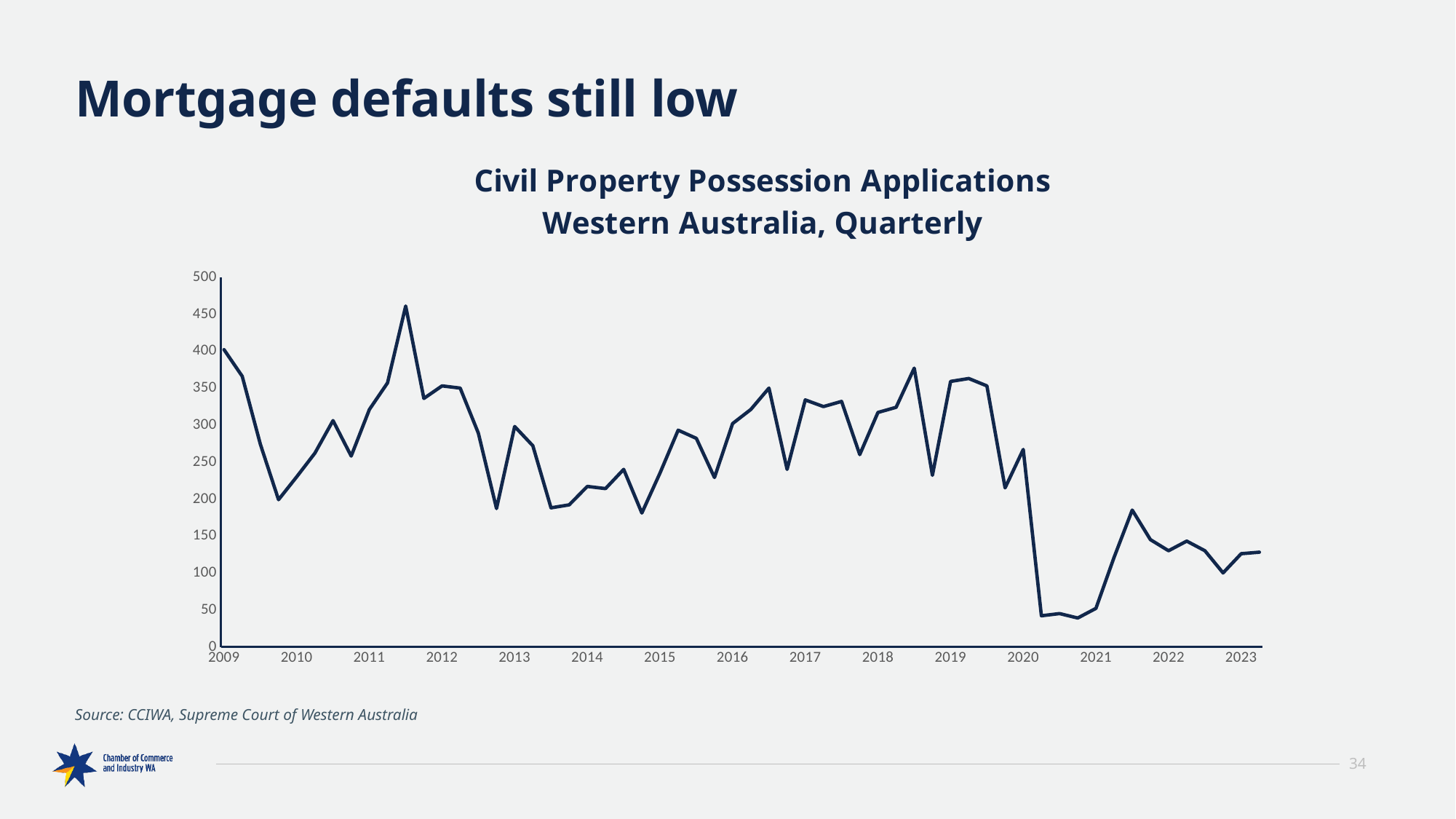
How many year labels are shown on the x axis of the chart? 15 Is the lowest point on the chart greater or less than 50? less Is the highest point on the chart greater or less than 400? greater Is the value at the start of 2023 greater or less than 150? less Which is larger, the value at the start of 2019 or the value at the start of 2023? 2019 What kind of chart is shown on the slide? Line chart Overall, do the values rise or fall from 2009 to 2023? fall What is the title of the chart? Civil Property Possession Applications Western Australia, Quarterly How many data series are plotted on the chart? 1 In which year does the line reach its highest point? 2011